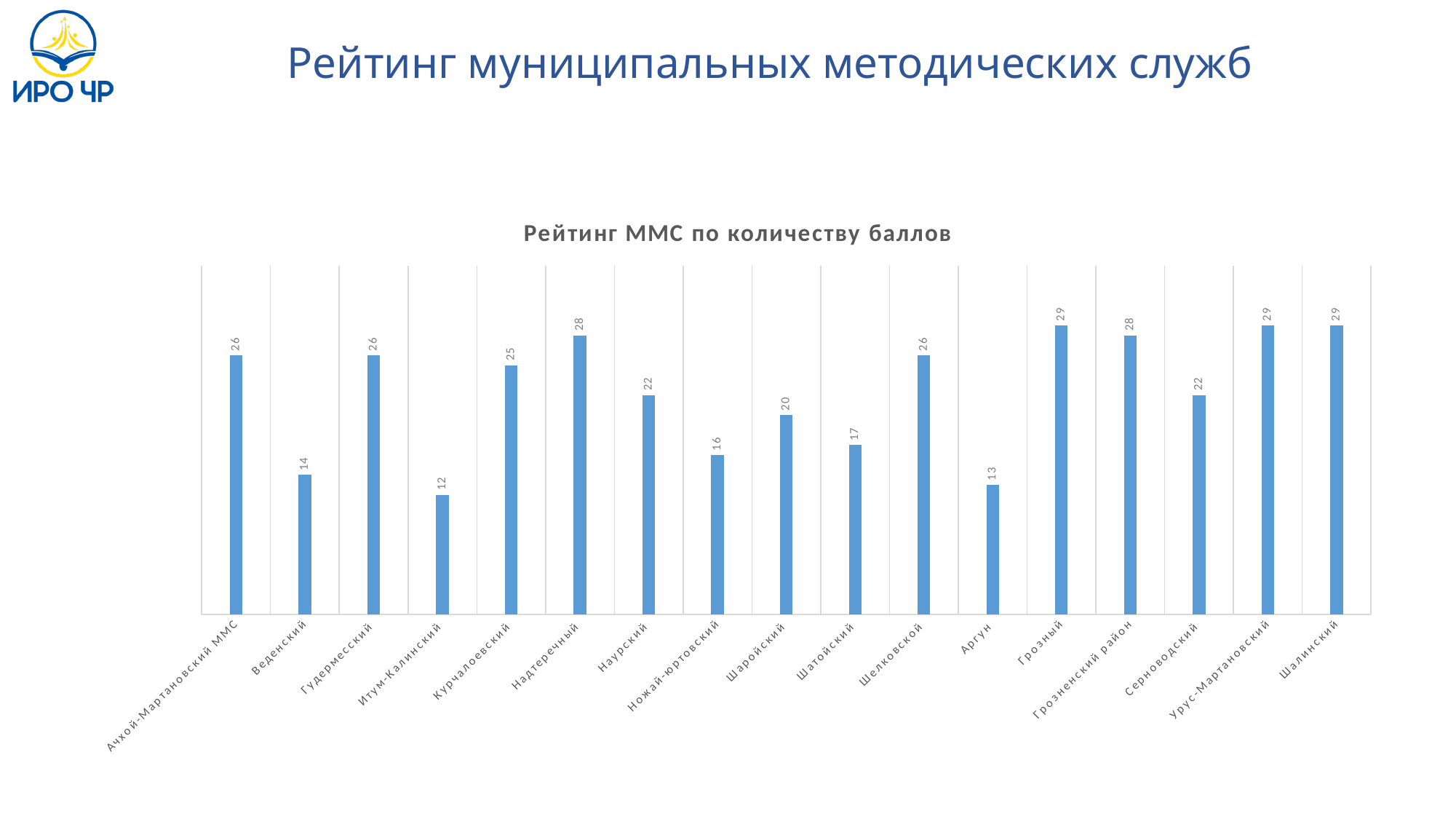
What kind of chart is shown on the slide? Bar chart What is the difference between the values for Грозный and Веденский? 15 What is the highest value shown in the chart? 29 Which is larger, the value for Наурский or the value for Шатойский? Наурский What is the value for Надтеречный in the chart? 28 What is the title of the chart? Рейтинг ММС по количеству баллов What is the value for Шаройский? 20 What is the difference between the values for Курчалоевский and Ножай-юртовский? 9 How many categories are shown in the chart? 17 What is the value for Аргун? 13 Which category has the lowest value in the chart? Итум-Калинский What is the value for Итум-Калинский? 12